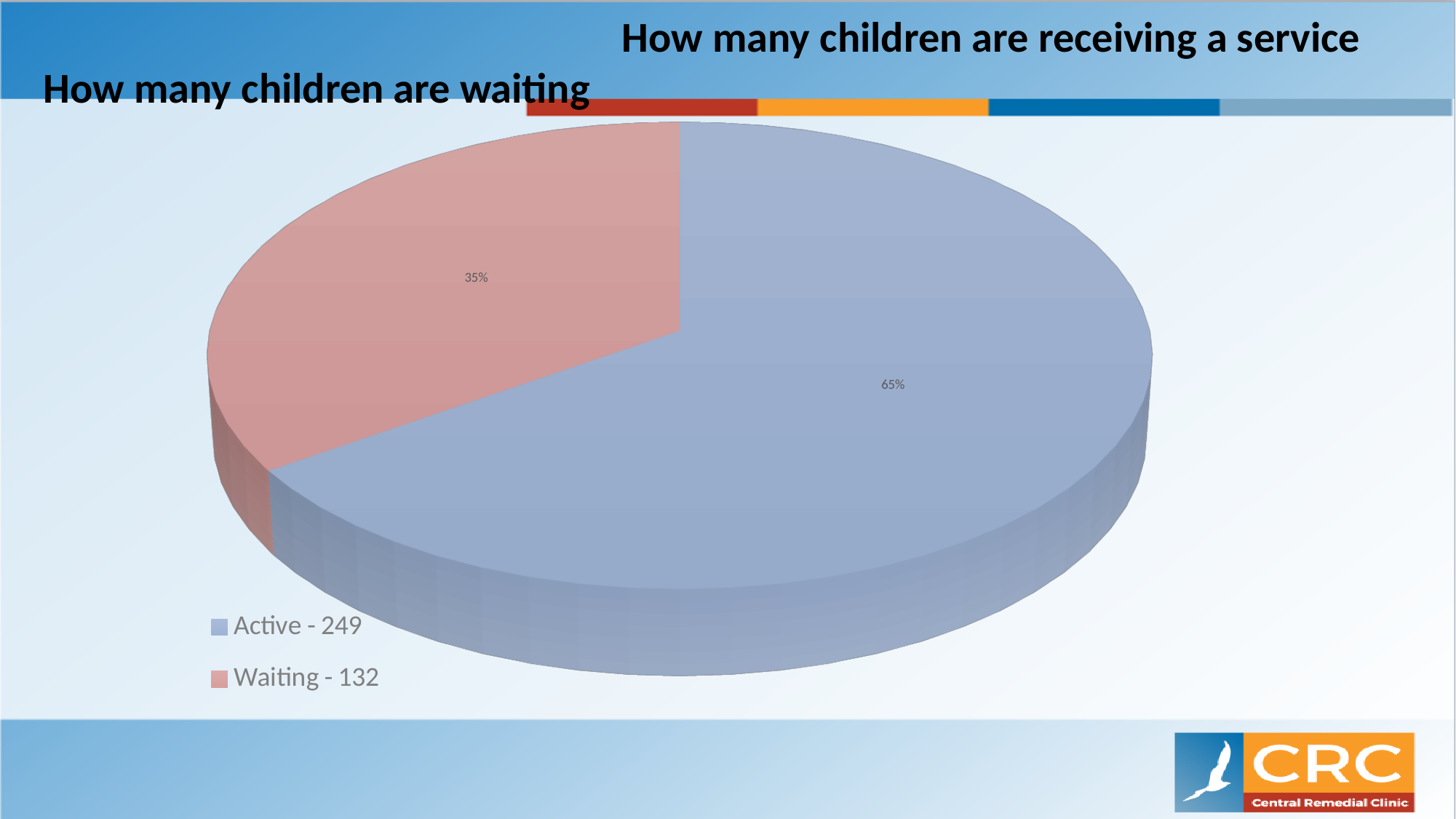
Which slice is larger, Active or Waiting? Active How many children are listed as Waiting in the legend? 132 What is the difference between the number of Active children and the number of Waiting children? 117 What is the total number of children across both categories in the legend? 381 How many slices does the pie chart have? 2 What percentage of the pie is the Waiting slice? 35% What kind of chart is shown on the slide? pie chart What percentage of the pie is the Active slice? 65% Which category has the smallest share of the pie? Waiting How many children are listed as Active in the legend? 249 What colour is the Waiting slice? pink/red How many entries does the legend list? 2